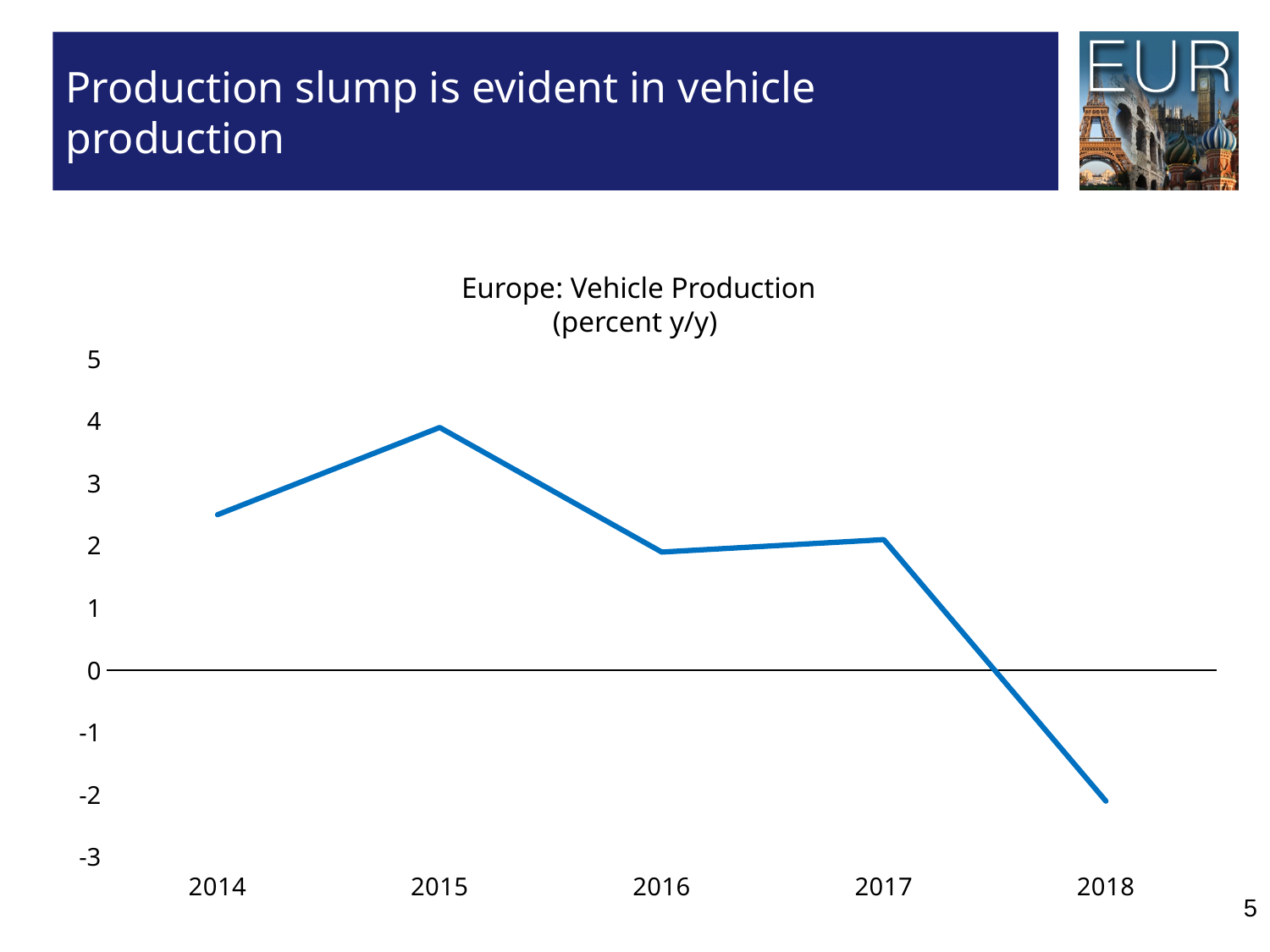
Is the value for 2018 greater or less than -1? less Is the value for 2016 greater or less than 3? less Is the value for 2015 greater or less than 3? greater Does the line rise or fall between 2017 and 2018? fall Which year has the larger value, 2017 or 2018? 2017 Which year has the lowest vehicle production growth in the chart? 2018 What kind of chart is shown on the slide? line chart What is the title of the chart? Europe: Vehicle Production (percent y/y) How many years are plotted on the x axis of the chart? 5 Which year has the highest vehicle production growth in the chart? 2015